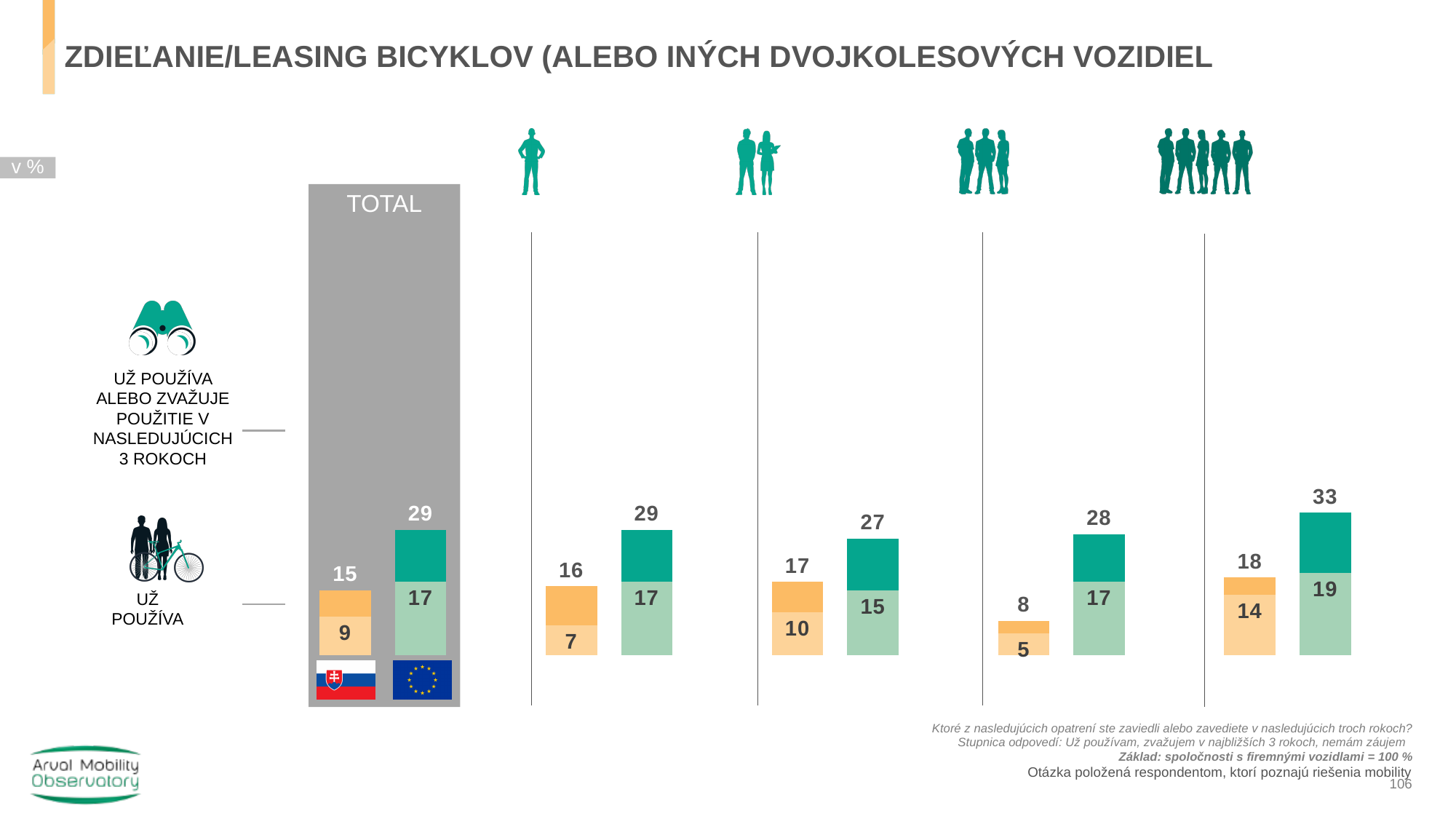
For the first group from the left (one-person icon), what is the difference between the EU and Slovakia values for 'už používa'? 10 What kind of chart is shown on the slide? Stacked bar chart In the TOTAL column, what is the EU value for 'už používa'? 17 For the third group from the left (three-person icon), what is the Slovakia value for 'už používa alebo zvažuje použitie v nasledujúcich 3 rokoch'? 8 For the second group from the left (two-person icon), which is larger: the Slovakia or the EU value for 'už používa'? EU (15) Among the four company-size groups, which has the lowest Slovakia value for 'už používa'? The third group (three-person icon), 5 Among the four company-size groups, which has the highest EU value for 'už používa alebo zvažuje použitie v nasledujúcich 3 rokoch'? The fourth group (five-person icon), 33 In the TOTAL column, what is the difference between the EU and Slovakia values for 'už používa alebo zvažuje použitie v nasledujúcich 3 rokoch'? 14 In the TOTAL column, what is the EU value for 'už používa alebo zvažuje použitie v nasledujúcich 3 rokoch'? 29 In the TOTAL column, what is the Slovakia value for 'už používa alebo zvažuje použitie v nasledujúcich 3 rokoch'? 15 For the fourth group from the left (five-person icon), what is the Slovakia value for 'už používa'? 14 In what unit are the values on the chart expressed? %